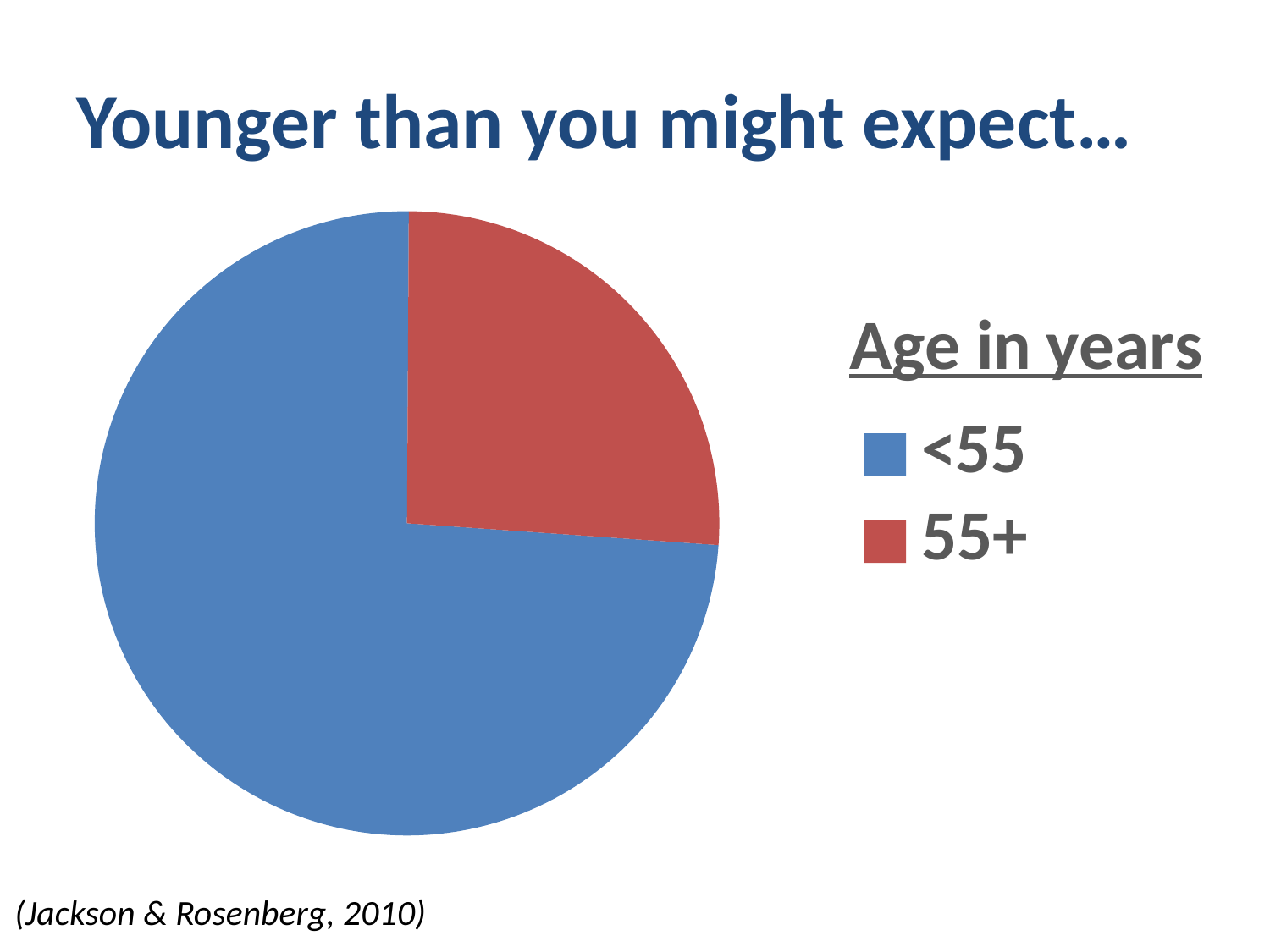
How many entries does the legend list? 2 What kind of chart is shown on the slide? pie chart Which age group has the largest slice of the pie? <55 Which slice is larger, <55 or 55+? <55 What colour is the slice for the 55+ age group? red How many slices does the pie chart have? 2 What is the title of the legend? Age in years Which age group has the smallest slice of the pie? 55+